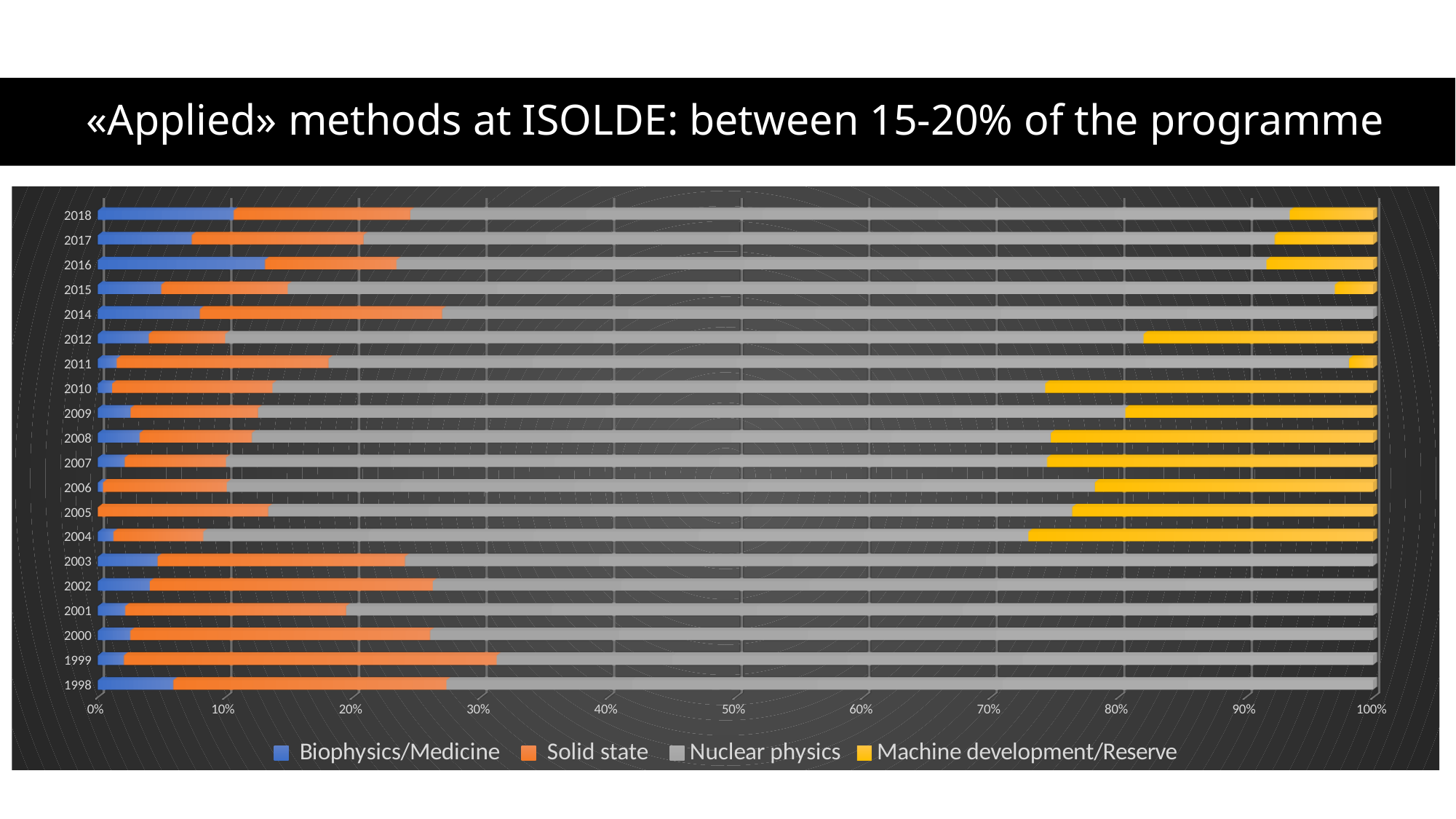
What is the title of the slide? «Applied» methods at ISOLDE: between 15-20% of the programme Which is larger, the Solid state share for 2014 or for 2015? 2014 Is the Machine development/Reserve share for 2011 greater or less than 10%? less Is the Machine development/Reserve share for 2004 greater or less than 20%? greater How many series does the legend list? 4 Which series is shown in yellow in the legend? Machine development/Reserve Is the Nuclear physics share for 2018 greater or less than 60%? greater What kind of chart is shown on the slide? bar chart Which year has the largest Solid state share? 1999 How many years are plotted on the chart? 20